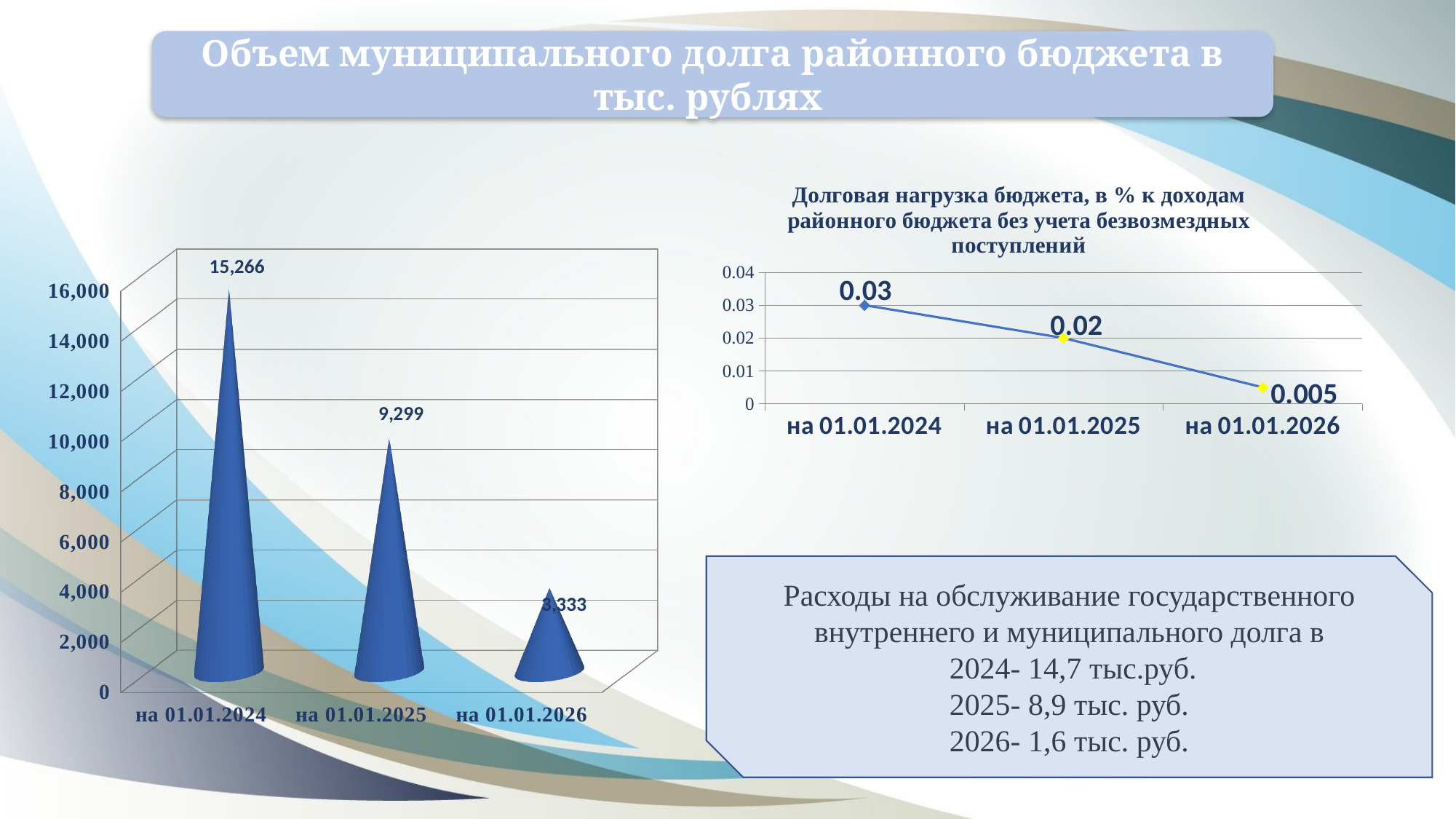
On the left chart (Объем муниципального долга), which date has the highest value? на 01.01.2024 On the left chart (Объем муниципального долга), which date has the lowest value? на 01.01.2026 What kind of chart is the chart titled 'Долговая нагрузка бюджета'? line chart On the left chart (Объем муниципального долга), what is the difference between the values for на 01.01.2024 and на 01.01.2025? 5,967 On the left chart (Объем муниципального долга), what is the value for на 01.01.2024? 15,266 On the left chart (Объем муниципального долга), what is the value for на 01.01.2025? 9,299 On the left chart (Объем муниципального долга), do the values rise or fall from на 01.01.2024 to на 01.01.2026? fall On the left chart (Объем муниципального долга), how many categories are plotted? 3 On the left chart (Объем муниципального долга), what is the value for на 01.01.2026? 3,333 On the chart titled 'Долговая нагрузка бюджета', what is the value for на 01.01.2025? 0.02 On the chart titled 'Долговая нагрузка бюджета', what is the value for на 01.01.2026? 0.005 On the chart titled 'Долговая нагрузка бюджета', which date has the highest value? на 01.01.2024